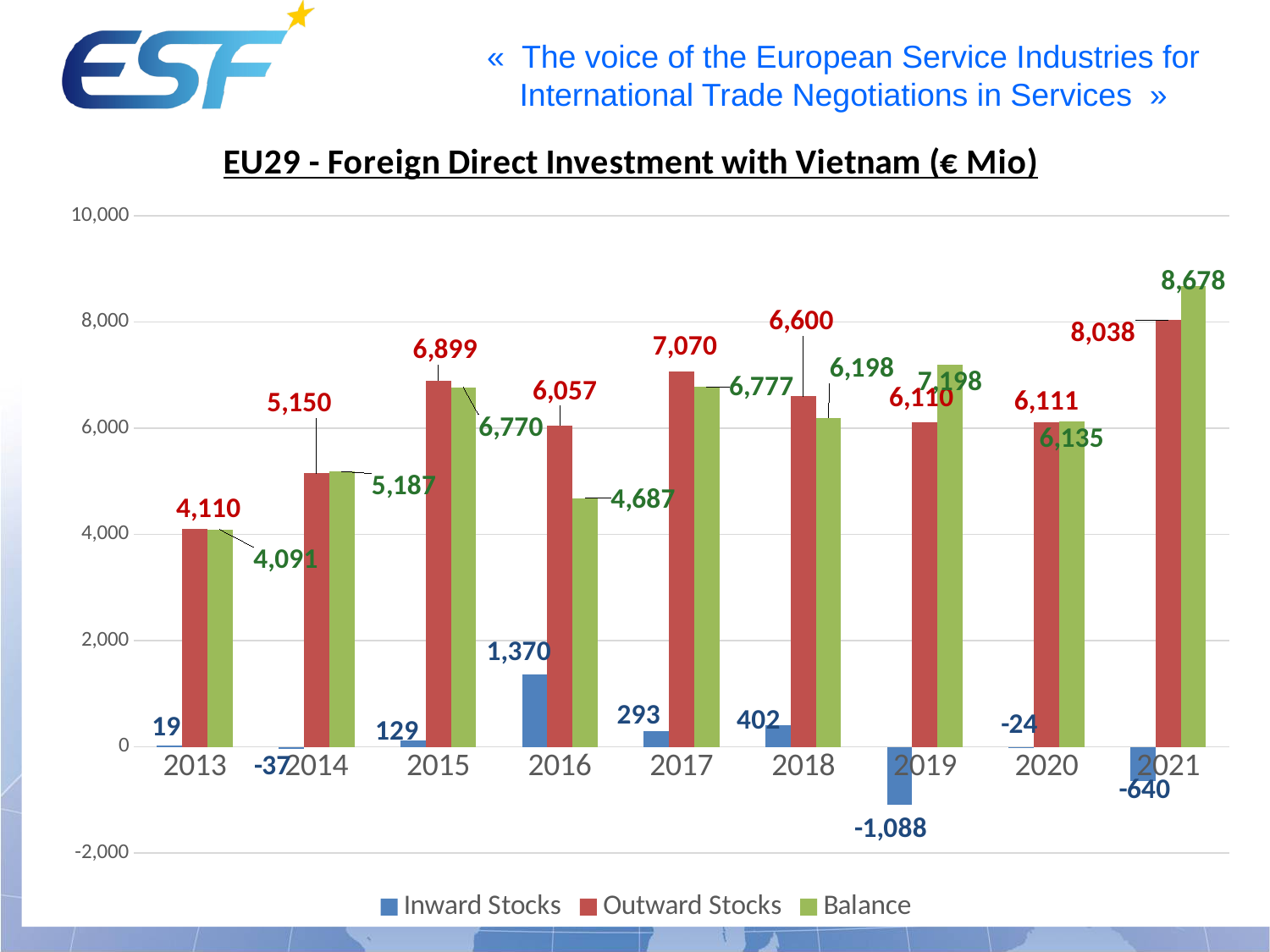
What is the difference between the Outward Stocks values for 2021 and 2013? 3,928 What is the Balance value for 2016? 4,687 Which is larger, the Inward Stocks value for 2016 or for 2018? 2016 Which year has the lowest Inward Stocks value? 2019 What is the Outward Stocks value for 2021? 8,038 How many series does the legend list? 3 How many years are shown on the x axis? 9 Which colour represents the Balance series in the legend? Green What kind of chart is shown on the slide? Bar chart Is the Outward Stocks value for 2017 greater or less than 6,000? greater What is the Inward Stocks value for 2019? -1,088 Which year has the highest Balance value? 2021